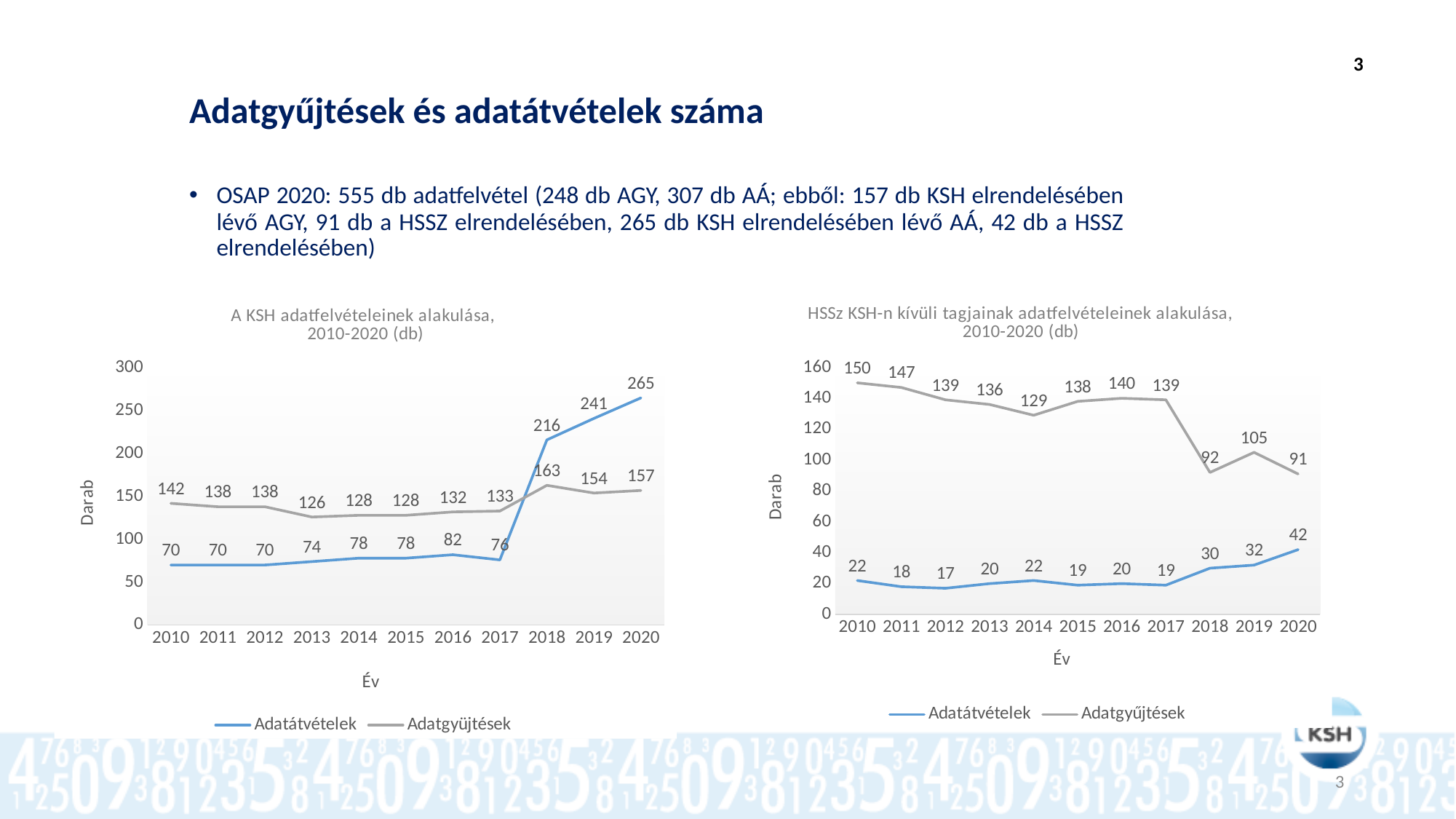
How many series does the legend of the right chart (HSSz KSH-n kívüli tagjainak adatfelvételeinek alakulása) list? 2 In the right chart (HSSz KSH-n kívüli tagjainak adatfelvételeinek alakulása), what is the value of Adatgyűjtések in 2014? 129 In the right chart (HSSz KSH-n kívüli tagjainak adatfelvételeinek alakulása), in which year is Adatátvételek lowest? 2012 In the right chart (HSSz KSH-n kívüli tagjainak adatfelvételeinek alakulása), does Adatgyűjtések rise or fall from 2017 to 2018? Fall What type of chart is the left chart (A KSH adatfelvételeinek alakulása)? Line chart How many years are plotted on the x axis of the right chart (HSSz KSH-n kívüli tagjainak adatfelvételeinek alakulása)? 11 In the left chart (A KSH adatfelvételeinek alakulása), in which year is Adatgyűjtések highest? 2018 In the left chart (A KSH adatfelvételeinek alakulása), what is the value of Adatátvételek in 2020? 265 In the left chart (A KSH adatfelvételeinek alakulása), which is larger in 2019: Adatátvételek or Adatgyűjtések? Adatátvételek In the right chart (HSSz KSH-n kívüli tagjainak adatfelvételeinek alakulása), what is the difference between Adatgyűjtések in 2010 and in 2020? 59 In the left chart (A KSH adatfelvételeinek alakulása), what is the difference between Adatátvételek in 2018 and in 2017? 140 In the left chart (A KSH adatfelvételeinek alakulása), what is the value of Adatgyűjtések in 2013? 126